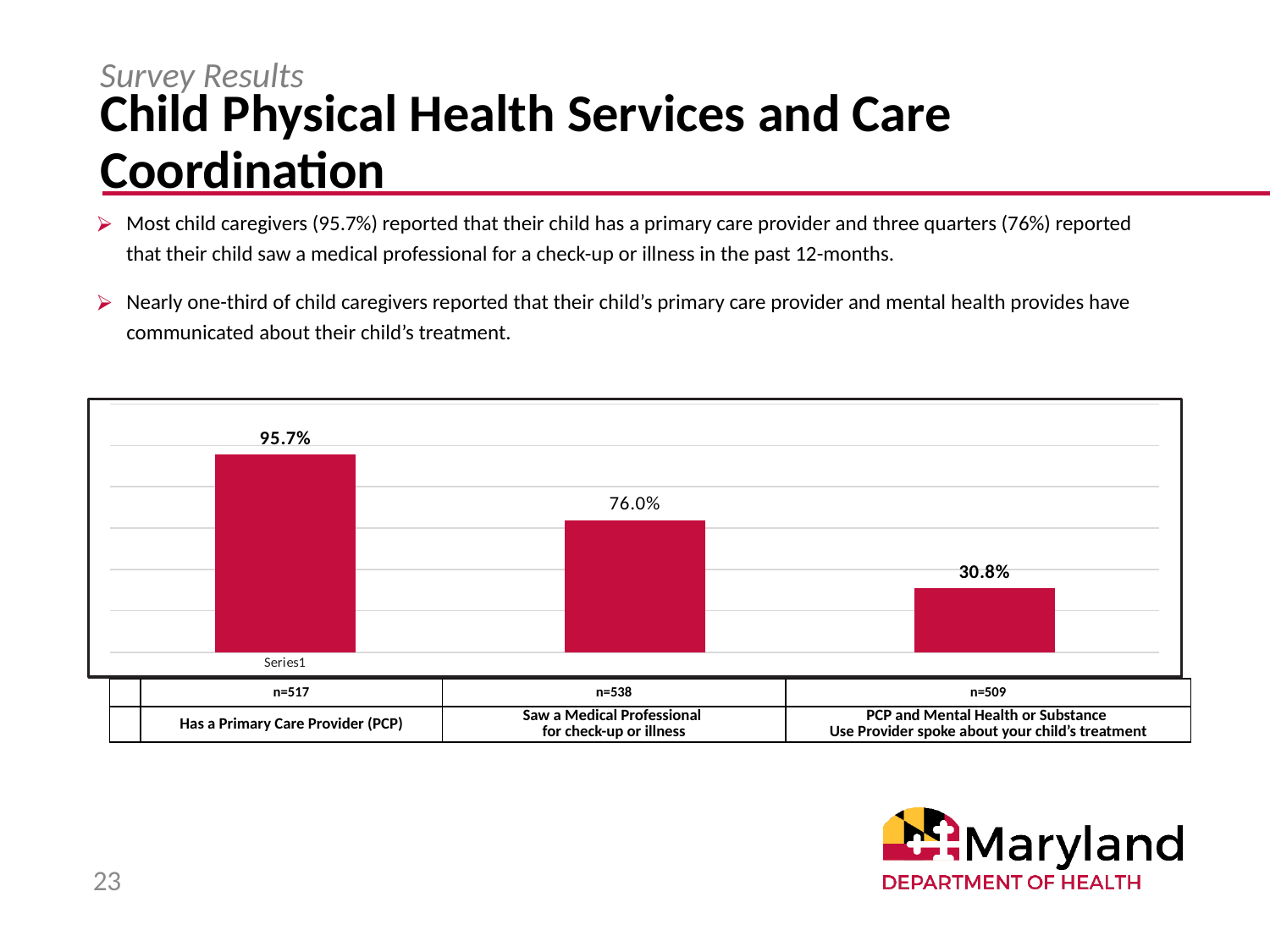
What kind of chart is shown on the slide? Bar chart What percentage is shown for 'PCP and Mental Health or Substance Use Provider spoke about your child's treatment'? 30.8% Do the values rise or fall from left to right across the chart? Fall What is the difference between the value for 'Has a Primary Care Provider (PCP)' and the value for 'Saw a Medical Professional for check-up or illness'? 19.7% Which category has the lowest value in the chart? PCP and Mental Health or Substance Use Provider spoke about your child's treatment Which category has the highest value in the chart? Has a Primary Care Provider (PCP) What is the difference between the value for 'Saw a Medical Professional for check-up or illness' and the value for 'PCP and Mental Health or Substance Use Provider spoke about your child's treatment'? 45.2% What percentage of child caregivers reported that their child has a primary care provider (PCP)? 95.7% Which is larger: the value for 'Saw a Medical Professional for check-up or illness' or the value for 'PCP and Mental Health or Substance Use Provider spoke about your child's treatment'? Saw a Medical Professional for check-up or illness What is the sample size (n) shown for the 'Saw a Medical Professional for check-up or illness' category? n=538 How many categories are shown in the chart? 3 What percentage is shown for 'Saw a Medical Professional for check-up or illness'? 76.0%